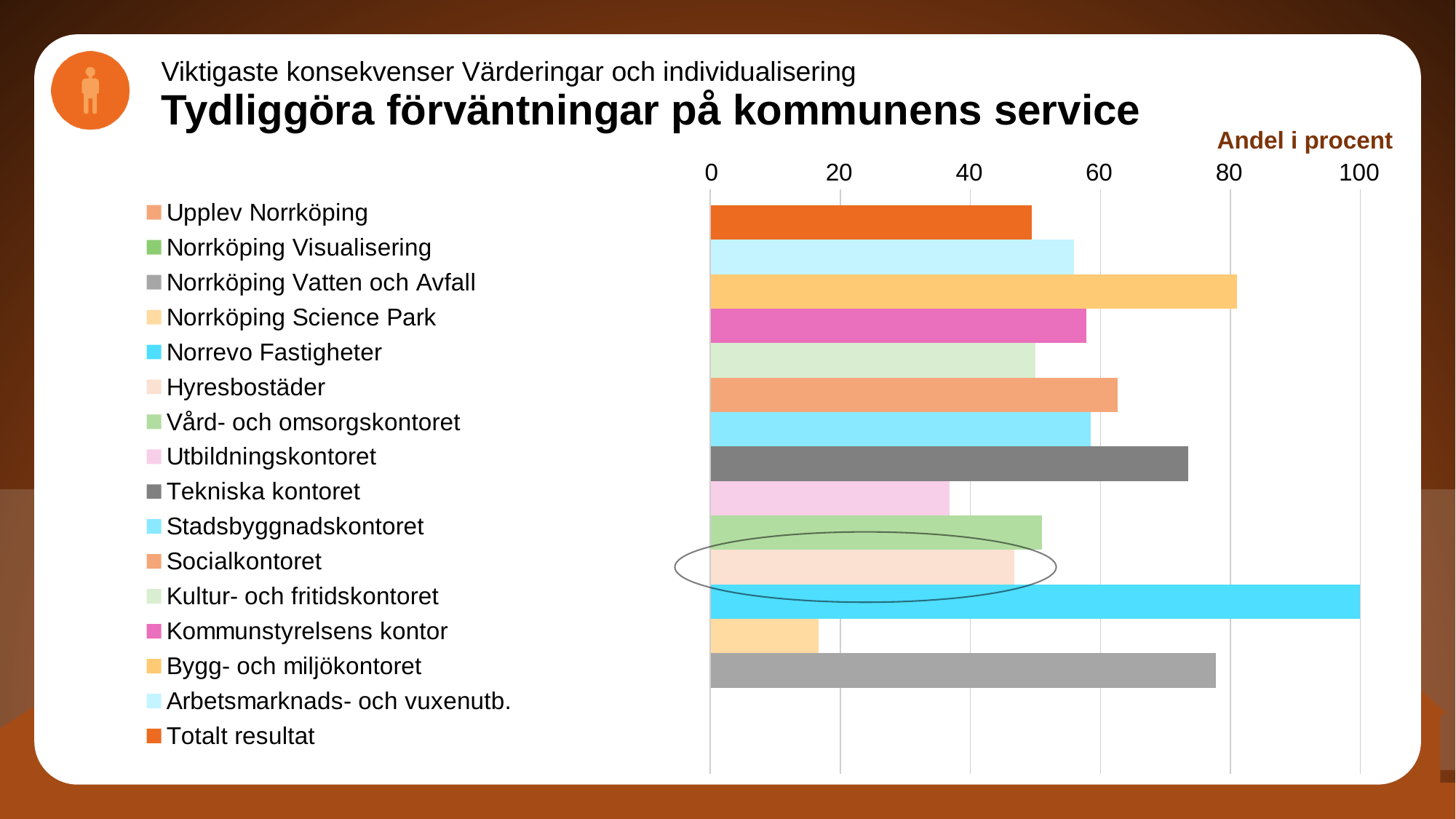
Is the value for Norrköping Vatten och Avfall greater or less than 60? greater Is the value for Tekniska kontoret greater or less than 60? greater Which has the larger value, Tekniska kontoret or Utbildningskontoret? Tekniska kontoret Which has the larger value, Bygg- och miljökontoret or Kultur- och fritidskontoret? Bygg- och miljökontoret What kind of chart is shown on the slide? bar chart What is the highest tick value shown on the value axis? 100 How many entries does the legend list? 16 Is the value for Norrköping Science Park greater or less than 20? less What is the axis title shown above the value axis? Andel i procent Which legend entry has the longest bar? Norrevo Fastigheter